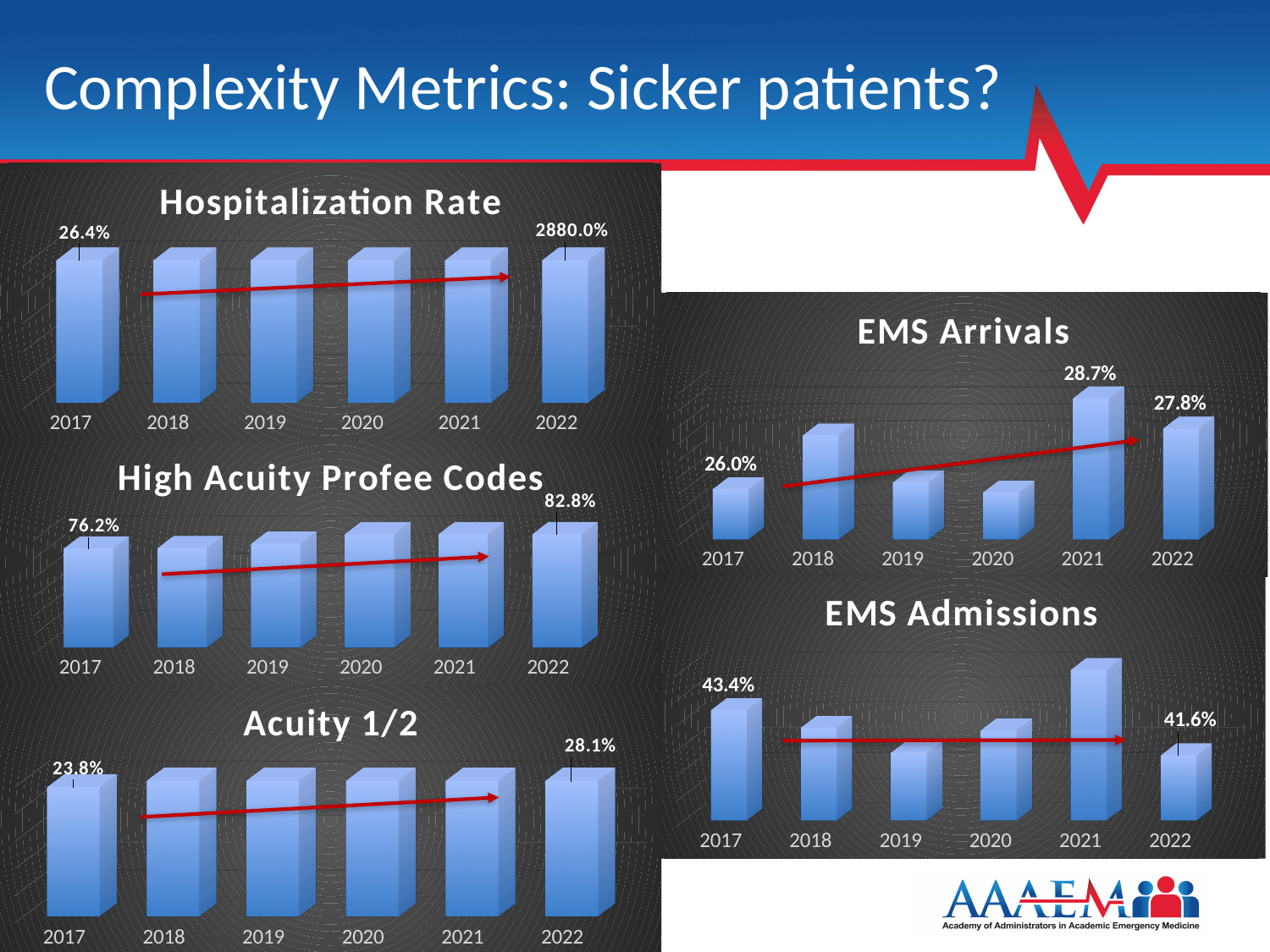
In the High Acuity Profee Codes chart, what is the value for 2022? 82.8% In the EMS Admissions chart, what is the value for 2022? 41.6% What type of chart is the Hospitalization Rate chart? Bar chart In the EMS Arrivals chart, what is the value for 2021? 28.7% In the EMS Arrivals chart, which year has the highest value? 2021 How many years are shown on the x axis of the EMS Arrivals chart? 6 In the Acuity 1/2 chart, what is the difference between the 2022 and 2017 values? 4.3 percentage points In the High Acuity Profee Codes chart, what is the difference between the 2022 and 2017 values? 6.6 percentage points In the Acuity 1/2 chart, what is the value for 2017? 23.8% In the Hospitalization Rate chart, what is the value for 2017? 26.4% In the EMS Admissions chart, which is larger, the value for 2017 or the value for 2022? 2017